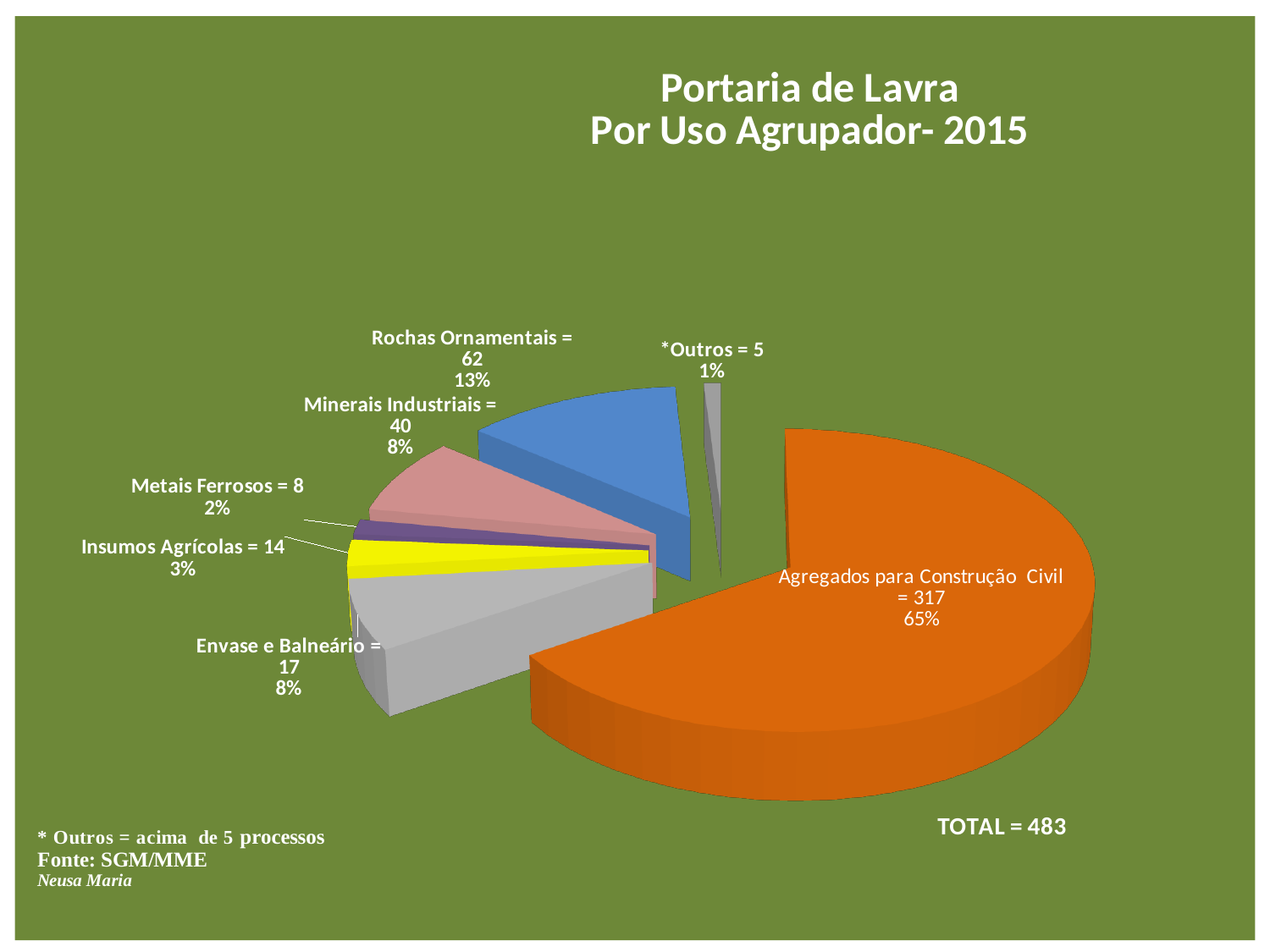
How many slices does the pie chart have? 7 Which is larger, the value for Insumos Agrícolas or the value for Metais Ferrosos? Insumos Agrícolas Which category has the largest slice? Agregados para Construção Civil What is the value for Envase e Balneário? 17 What is the value for Minerais Industriais? 40 What share of the pie does Agregados para Construção Civil represent? 65% What kind of chart is shown on the slide? pie chart What is the value for Rochas Ornamentais? 62 What is the difference between the values for Rochas Ornamentais and Minerais Industriais? 22 Which category has the smallest slice? *Outros What is the value for Agregados para Construção Civil? 317 What is the title of the chart? Portaria de Lavra Por Uso Agrupador- 2015